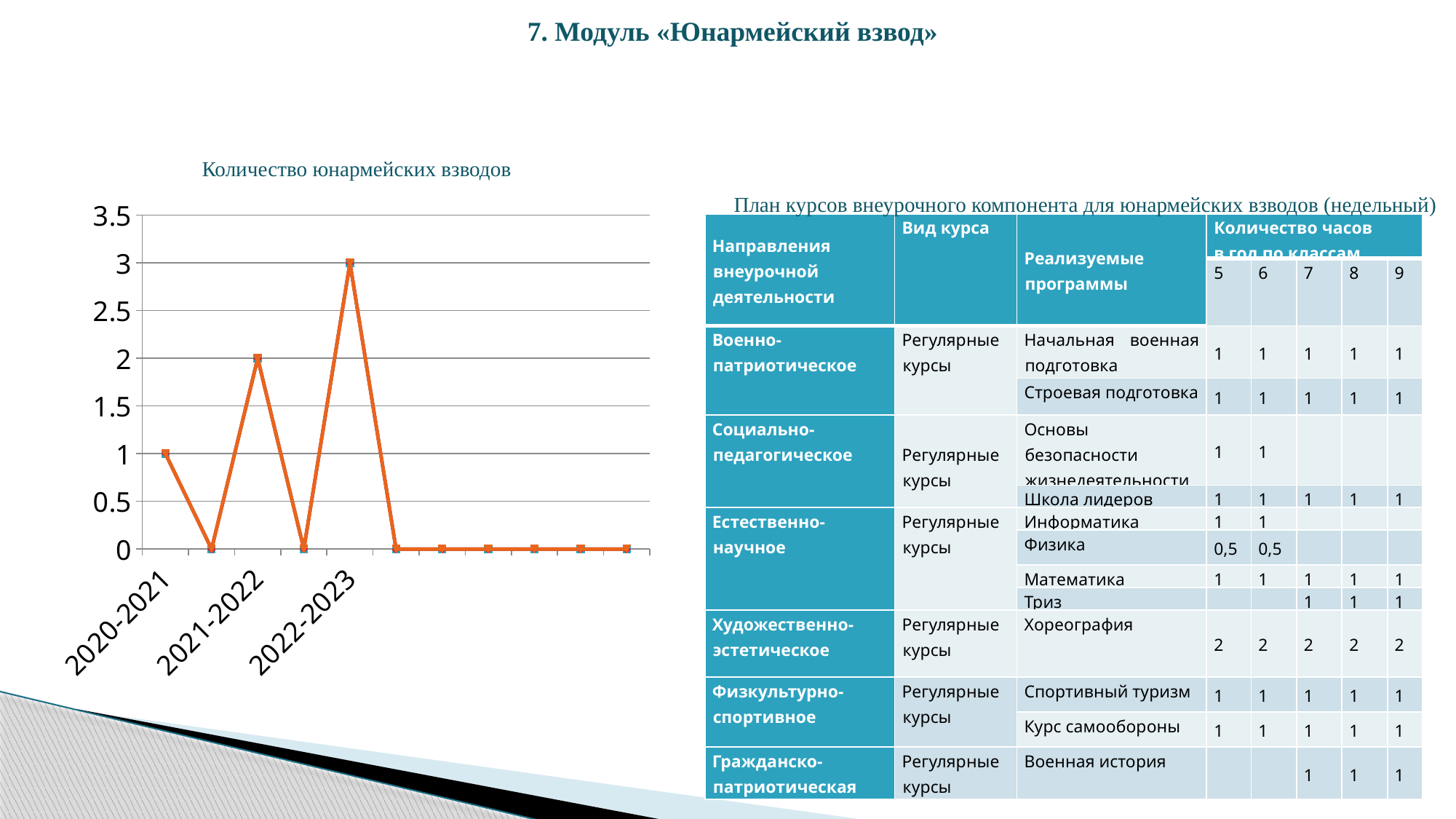
In the chart 'Количество юнармейских взводов', do the values for the labeled years rise or fall from 2020-2021 to 2022-2023? rise In the chart 'Количество юнармейских взводов', what is the difference between the values for 2022-2023 and 2020-2021? 2 In the chart 'Количество юнармейских взводов', how many year labels are shown on the x axis? 3 In the chart 'Количество юнармейских взводов', which is larger: the value for 2021-2022 or for 2020-2021? 2021-2022 What kind of chart is shown on the left of the slide? line chart In the chart 'Количество юнармейских взводов', is the value for 2022-2023 greater or less than 2.5? greater In the chart 'Количество юнармейских взводов', what is the value for 2021-2022? 2 In the chart 'Количество юнармейских взводов', what is the value for 2020-2021? 1 What is the title of the chart on the left of the slide? Количество юнармейских взводов In the chart 'Количество юнармейских взводов', which labeled year has the lowest value? 2020-2021 In the chart 'Количество юнармейских взводов', which labeled year has the highest value? 2022-2023 In the chart 'Количество юнармейских взводов', what is the value for 2022-2023? 3